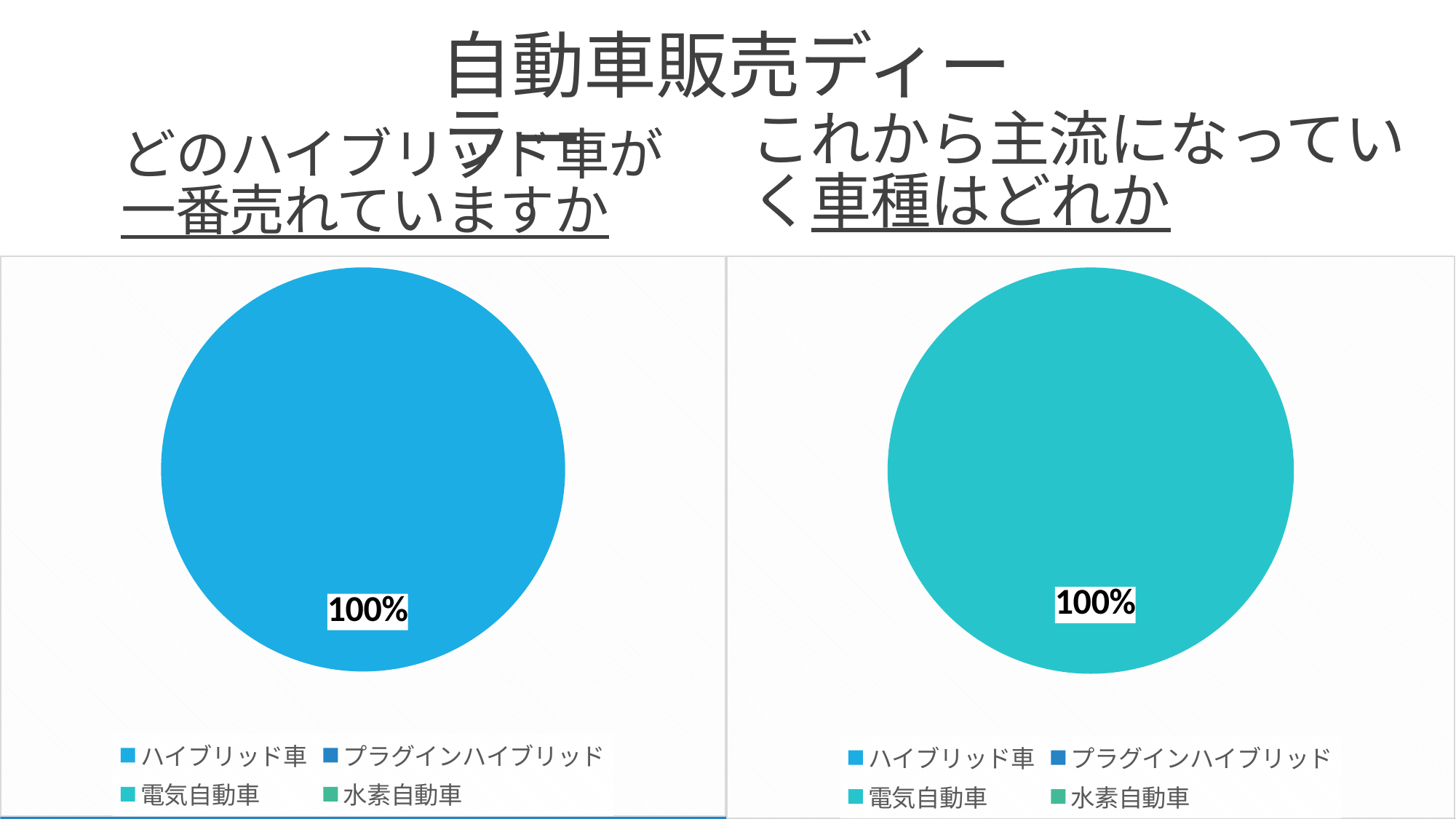
In the left chart (どのハイブリッド車が一番売れていますか), what share is printed on the pie? 100% How many entries does the legend of the left chart (どのハイブリッド車が一番売れていますか) list? 4 How many slices are visible in the right chart (これから主流になっていく車種はどれか)? 1 What kind of chart is the right chart (これから主流になっていく車種はどれか)? Pie chart How many entries does the legend of the right chart (これから主流になっていく車種はどれか) list? 4 What is the title of the chart on the left side of the slide? どのハイブリッド車が一番売れていますか What is the title of the chart on the right side of the slide? これから主流になっていく車種はどれか In the left chart (どのハイブリッド車が一番売れていますか), which legend category does the single slice filling the whole pie belong to? ハイブリッド車 In the right chart (これから主流になっていく車種はどれか), what share is printed on the pie? 100% How many slices are visible in the left chart (どのハイブリッド車が一番売れていますか)? 1 In the right chart (これから主流になっていく車種はどれか), which legend category does the single slice filling the whole pie belong to? 電気自動車 What kind of chart is the left chart (どのハイブリッド車が一番売れていますか)? Pie chart